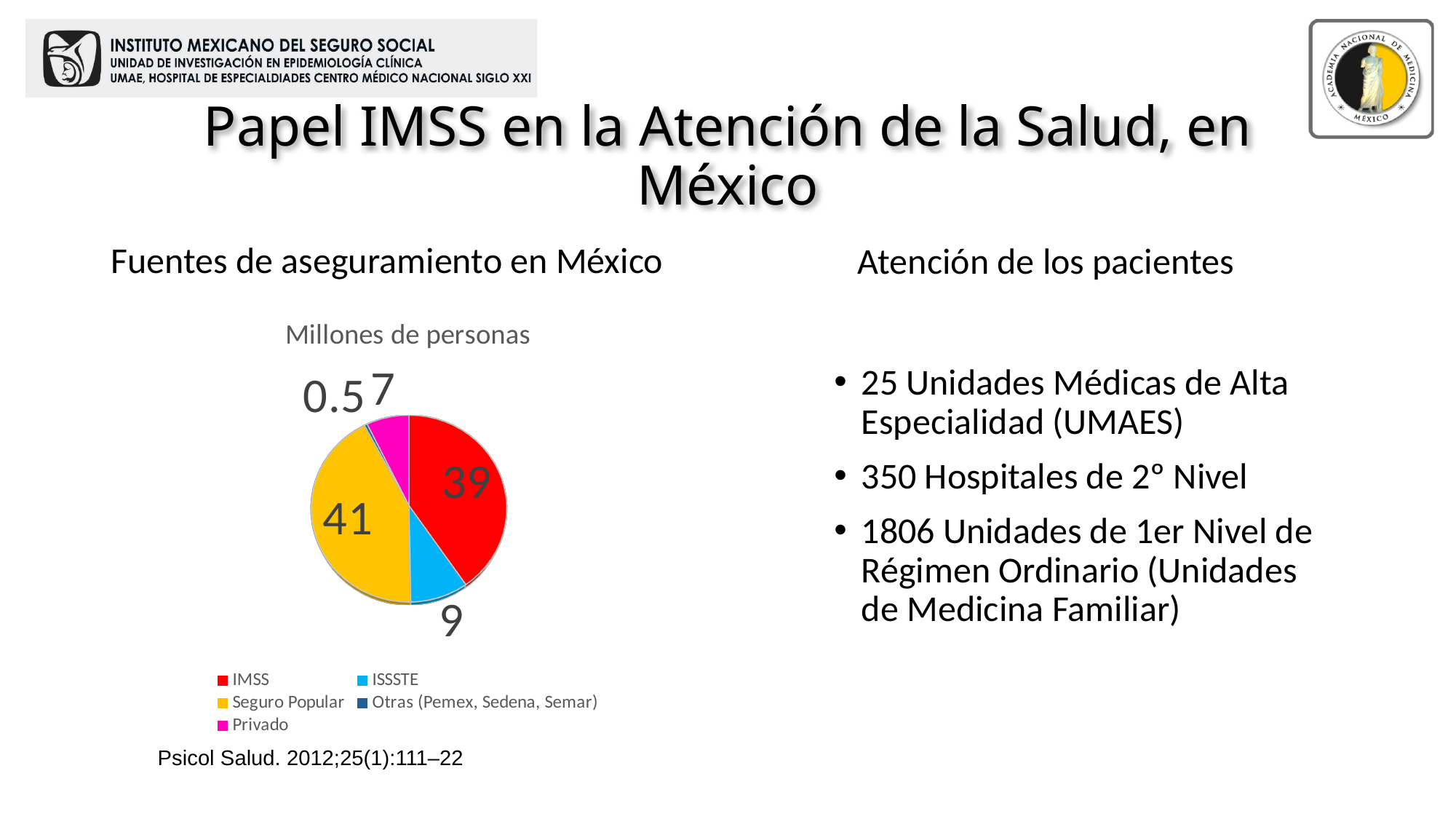
What value is shown for ISSSTE in the pie chart? 9 What is the difference between the values for Seguro Popular and IMSS? 2 Which category has the smallest slice in the pie chart? Otras (Pemex, Sedena, Semar) Which is larger, the value for ISSSTE or the value for Privado? ISSSTE What value is shown for Otras (Pemex, Sedena, Semar) in the pie chart? 0.5 What type of chart is shown on the slide? Pie chart Which category has the largest slice in the pie chart? Seguro Popular What is the difference between the values for IMSS and ISSSTE? 30 What value is shown for Seguro Popular in the pie chart? 41 What value is shown for IMSS in the pie chart? 39 How many categories does the pie chart show? 5 What value is shown for Privado in the pie chart? 7